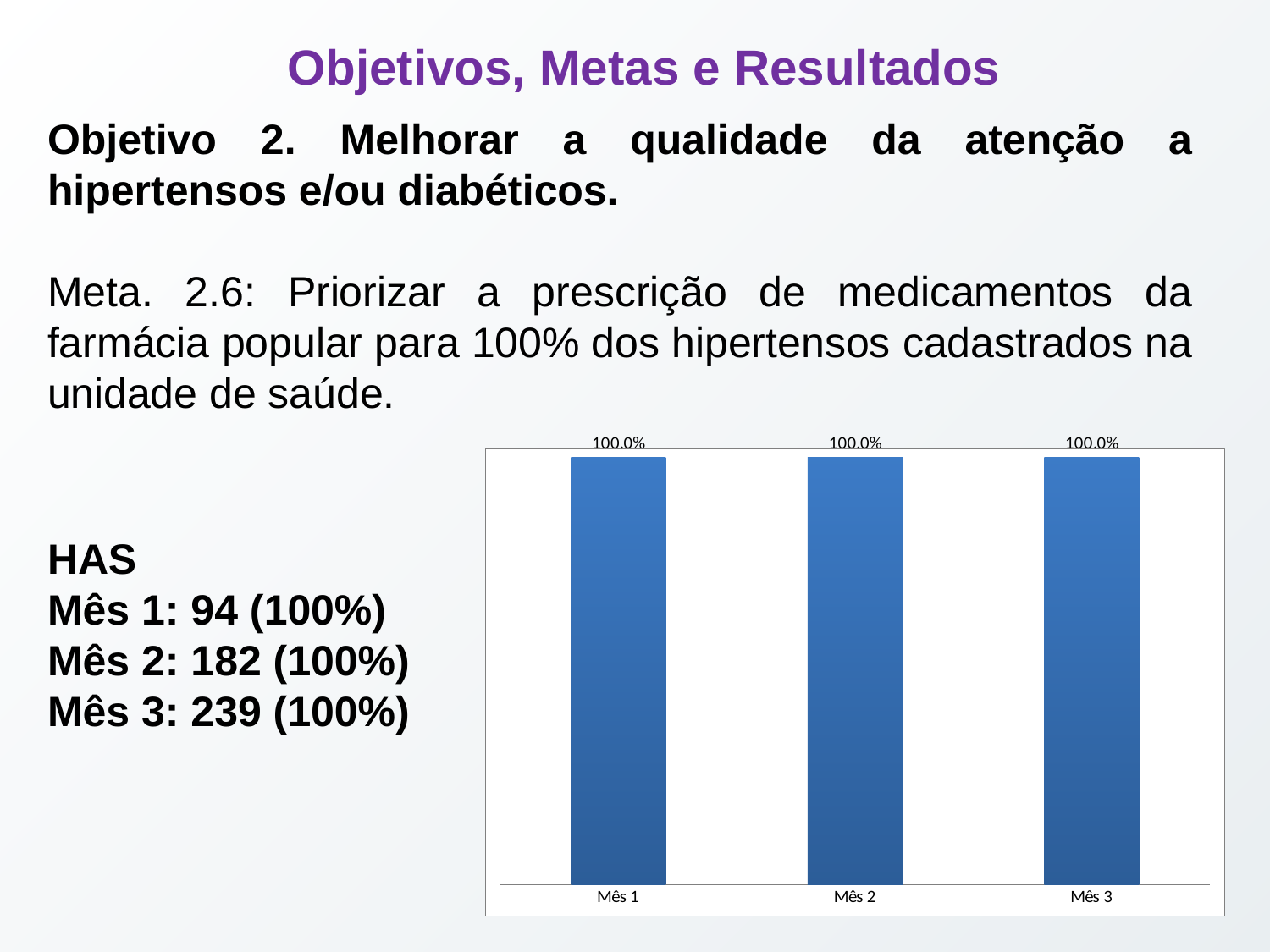
Is the value for Mês 2 in the chart greater or less than 50%? greater What is the difference between the values for Mês 3 and Mês 1 in the chart? 0.0% What are the category labels on the x axis of the chart? Mês 1, Mês 2, Mês 3 What is the value shown for Mês 1 in the chart? 100.0% What is the value shown for Mês 2 in the chart? 100.0% Do the values in the chart rise, fall, or stay the same from Mês 1 to Mês 3? Stay the same What is the value shown for Mês 3 in the chart? 100.0% How many categories are plotted in the chart? 3 What kind of chart is shown on the slide? Bar chart What colour are the bars in the chart? Blue